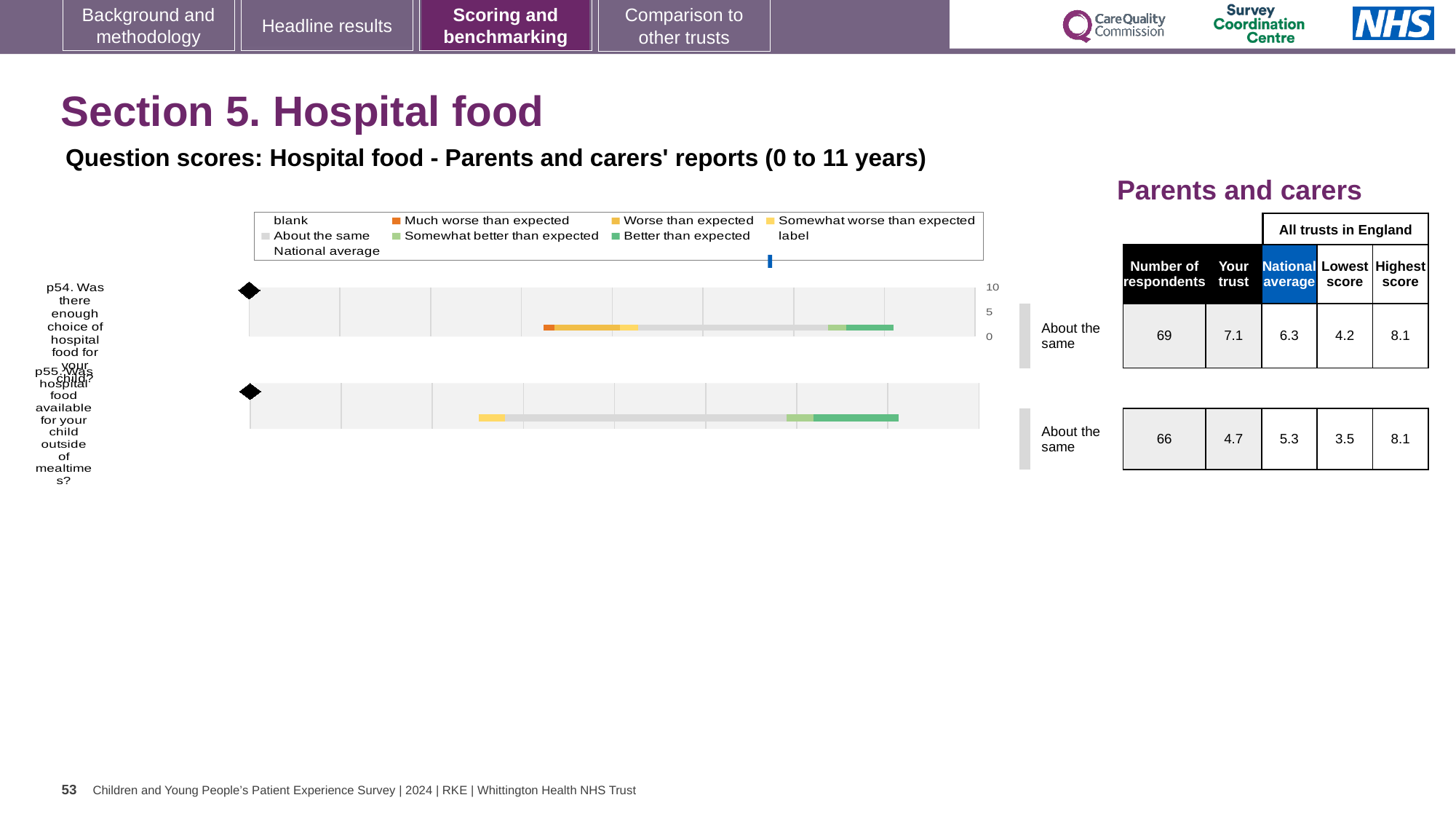
How many respondents answered p55? 66 By how much does the national average exceed the trust's score for p55? 0.6 What kind of chart is used to show the question scores for hospital food? bar chart For p54, which is higher: the trust's score or the national average? Your trust What is the 'Your trust' score for p54 (enough choice of hospital food for your child)? 7.1 Which of the two questions has the higher 'Your trust' score? p54 What is the national average score for p55 (hospital food available outside of mealtimes)? 5.3 What is the difference between the highest and lowest scores for p54? 3.9 How many survey questions are plotted in the hospital food chart? 2 What benchmark category is shown for p54? About the same For p55, which is higher: the trust's score or the national average? National average What is the highest score across all trusts in England for p54? 8.1